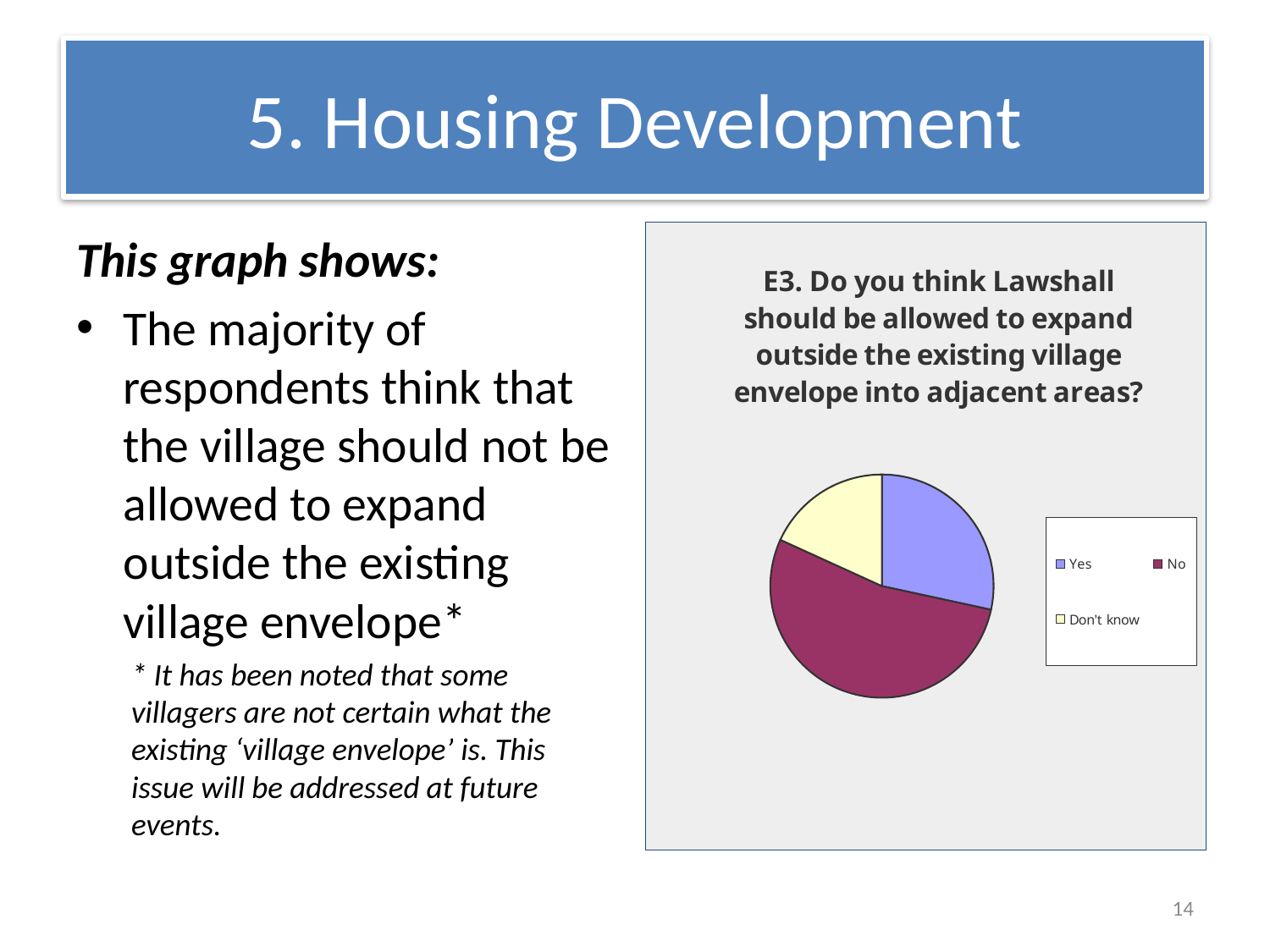
Which slice is larger in the pie chart, Yes or Don't know? Yes What colour is the No slice in the pie chart? dark magenta What kind of chart is shown on the slide? pie chart What is the title of the pie chart? E3. Do you think Lawshall should be allowed to expand outside the existing village envelope into adjacent areas? Which response has the smallest slice in the pie chart? Don't know Which slice is larger in the pie chart, No or Yes? No Which response has the largest slice in the pie chart? No How many entries does the legend of the pie chart list? 3 How many slices does the pie chart have? 3